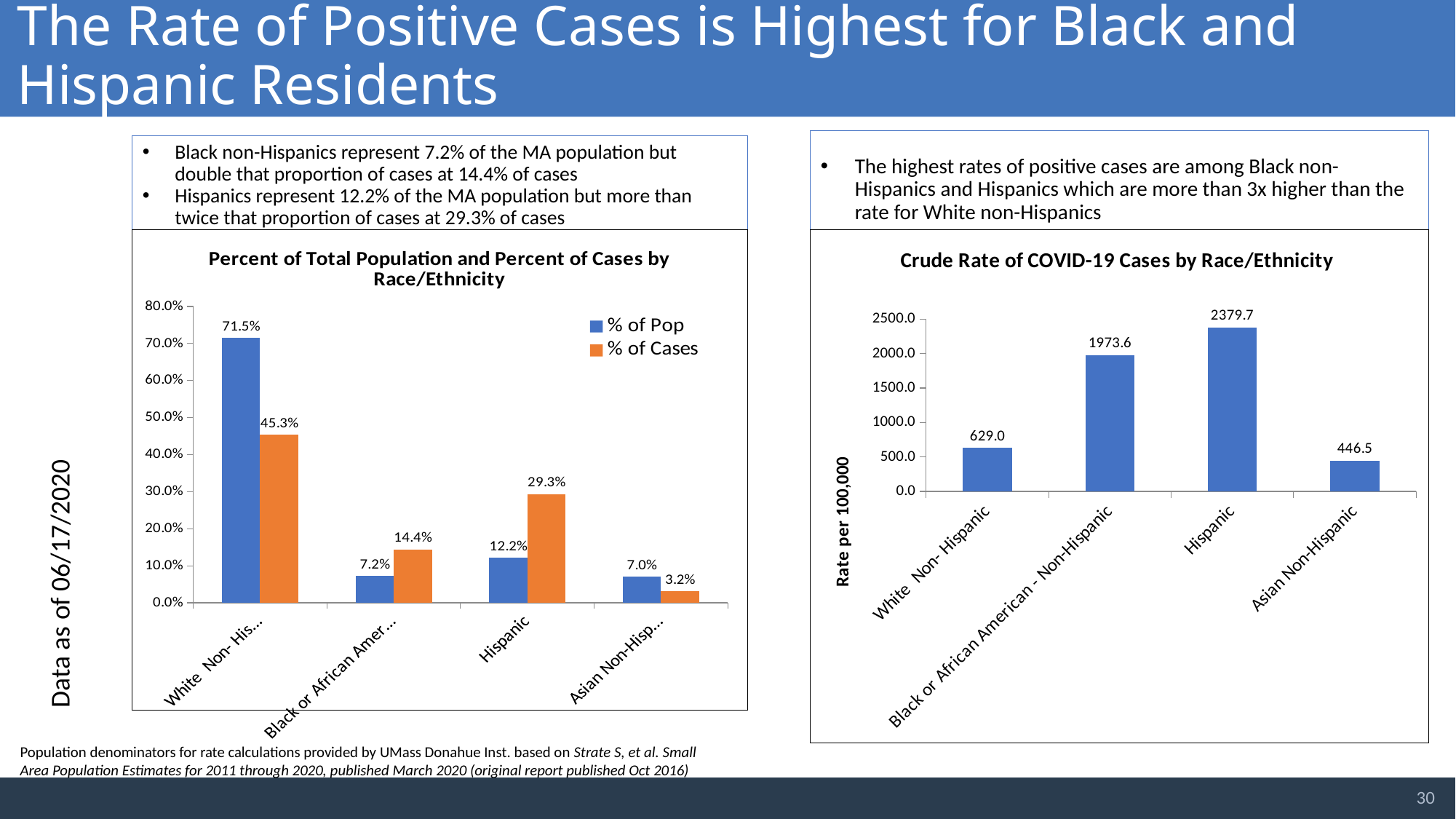
In the chart titled 'Percent of Total Population and Percent of Cases by Race/Ethnicity', what is the difference between % of Cases and % of Pop for Hispanic? 17.1% What kind of chart is the chart titled 'Crude Rate of COVID-19 Cases by Race/Ethnicity'? Bar chart In the chart titled 'Percent of Total Population and Percent of Cases by Race/Ethnicity', which is larger for Hispanic: % of Pop or % of Cases? % of Cases In the chart titled 'Crude Rate of COVID-19 Cases by Race/Ethnicity', which category has the highest rate? Hispanic In the chart titled 'Percent of Total Population and Percent of Cases by Race/Ethnicity', what is the % of Pop value for the first category (White Non-Hispanic)? 71.5% In the chart titled 'Crude Rate of COVID-19 Cases by Race/Ethnicity', which category has the lowest rate? Asian Non-Hispanic In the chart titled 'Percent of Total Population and Percent of Cases by Race/Ethnicity', how many series does the legend list? 2 In the chart titled 'Crude Rate of COVID-19 Cases by Race/Ethnicity', what is the rate for Asian Non-Hispanic? 446.5 In the chart titled 'Crude Rate of COVID-19 Cases by Race/Ethnicity', how many categories are shown? 4 In the chart titled 'Crude Rate of COVID-19 Cases by Race/Ethnicity', what is the difference between the rate for Hispanic and the rate for White Non-Hispanic? 1750.7 In the chart titled 'Percent of Total Population and Percent of Cases by Race/Ethnicity', what is the % of Cases value for Hispanic? 29.3% In the chart titled 'Crude Rate of COVID-19 Cases by Race/Ethnicity', what is the rate for Hispanic? 2379.7